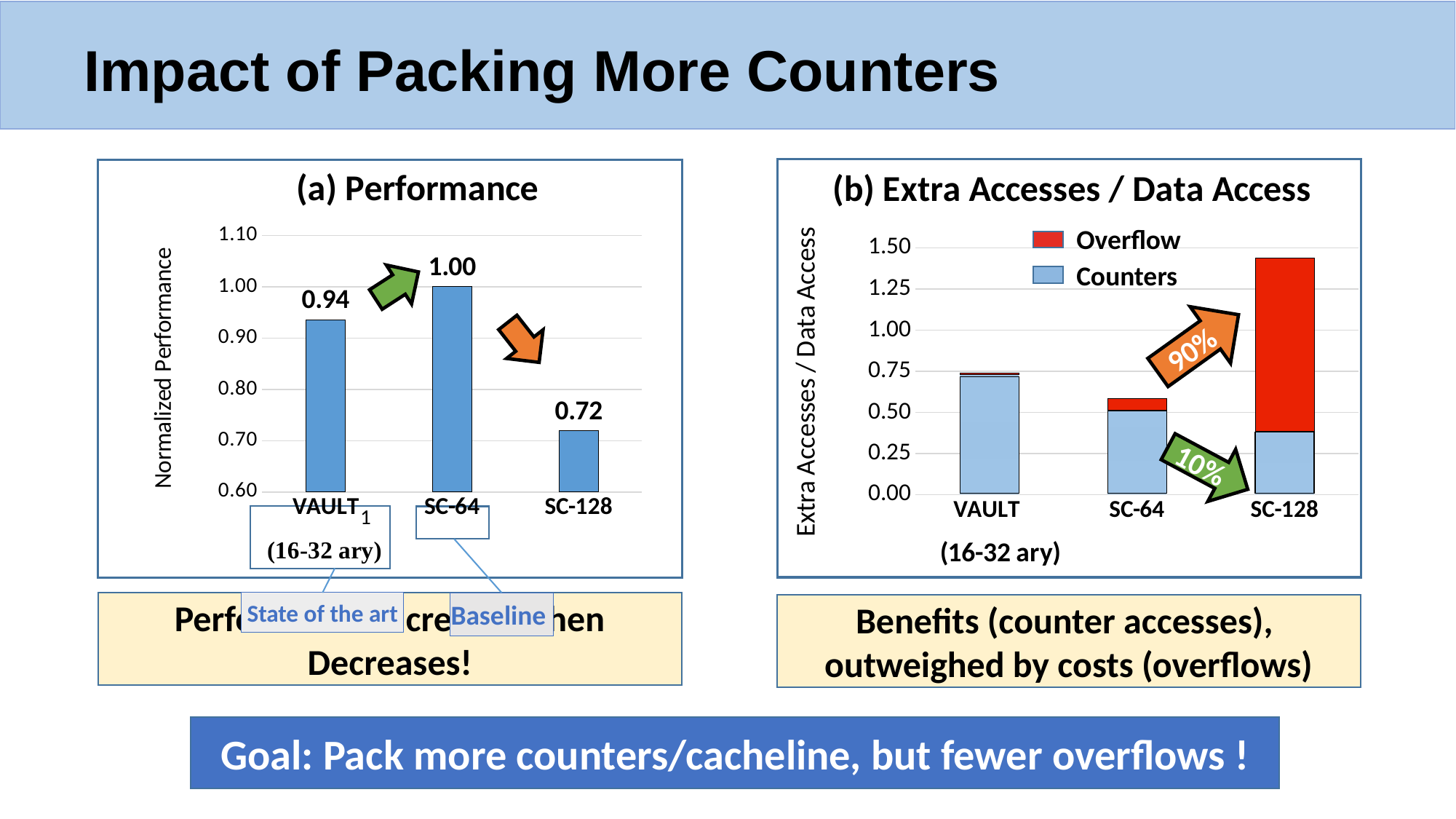
In the (b) Extra Accesses / Data Access chart, how many series does the legend list? 2 In the (b) Extra Accesses / Data Access chart, is the total stacked value for SC-128 greater or less than 1.25? greater In the (b) Extra Accesses / Data Access chart, is the Counters value for SC-128 greater or less than 0.50? less In the (b) Extra Accesses / Data Access chart, which category has the tallest stacked bar? SC-128 In the (a) Performance chart, which category has the highest normalized performance? SC-64 In the (b) Extra Accesses / Data Access chart, which series is shown in red? Overflow In the (a) Performance chart, what is the difference between the values for SC-64 and SC-128? 0.28 In the (a) Performance chart, how many categories are shown on the x axis? 3 In the (a) Performance chart, which category has the lowest normalized performance? SC-128 In the (a) Performance chart, what is the normalized performance for SC-128? 0.72 What kind of chart is the (a) Performance chart? bar chart In the (a) Performance chart, what is the normalized performance for VAULT? 0.94